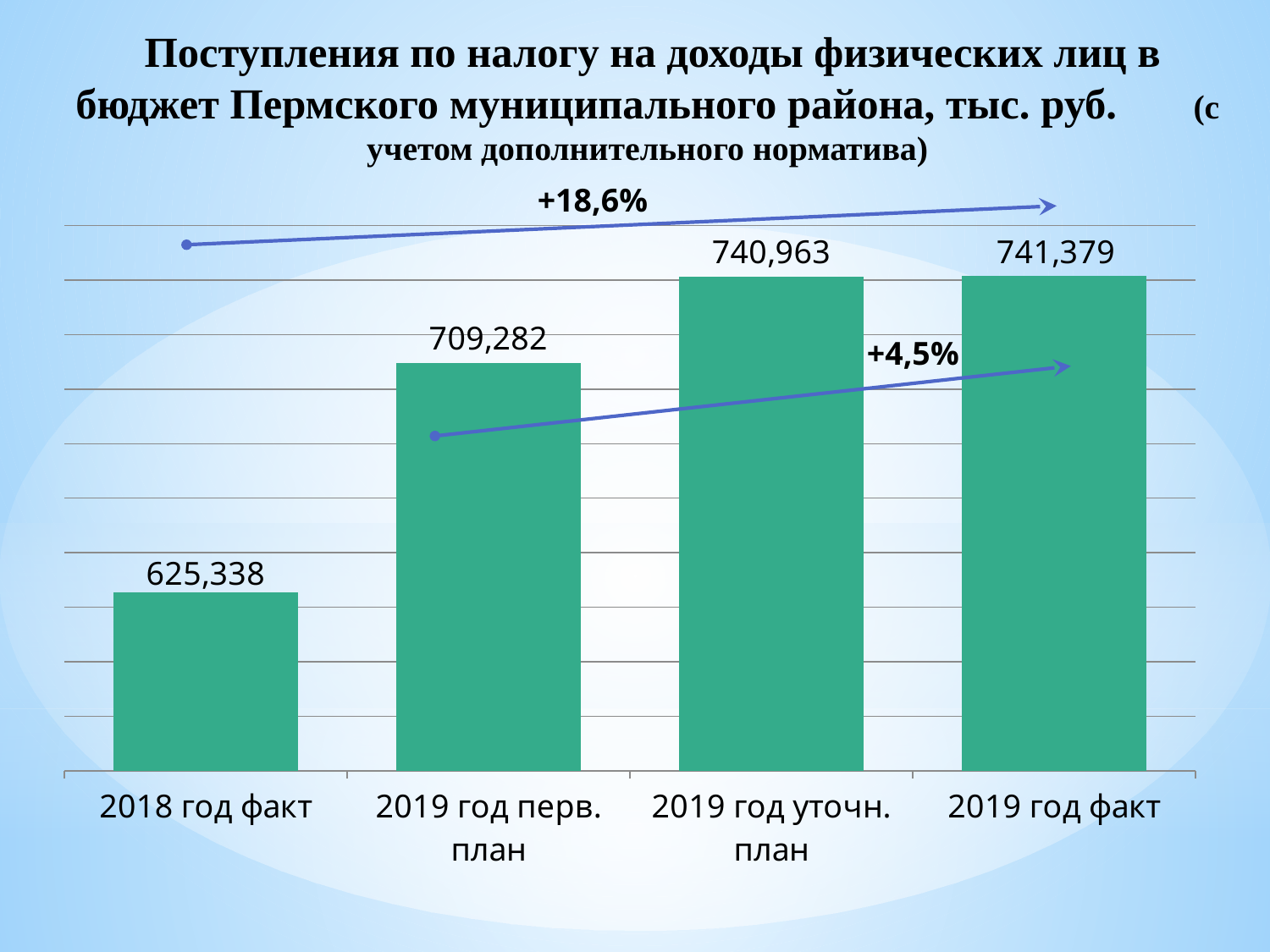
What is the difference between the values for "2019 год факт" and "2018 год факт"? 116,041 What is the value for "2019 год перв. план"? 709,282 How many categories are shown on the x axis of the chart? 4 Do the values rise or fall from left to right along the x axis? Rise What type of chart is shown on the slide? Bar chart What is the value for "2018 год факт"? 625,338 Which category has the lowest value? 2018 год факт What is the value for "2019 год факт"? 741,379 What is the value for "2019 год уточн. план"? 740,963 What is the difference between the values for "2019 год уточн. план" and "2019 год перв. план"? 31,681 Which category has the highest value? 2019 год факт Which is larger, the value for "2019 год перв. план" or the value for "2018 год факт"? 2019 год перв. план